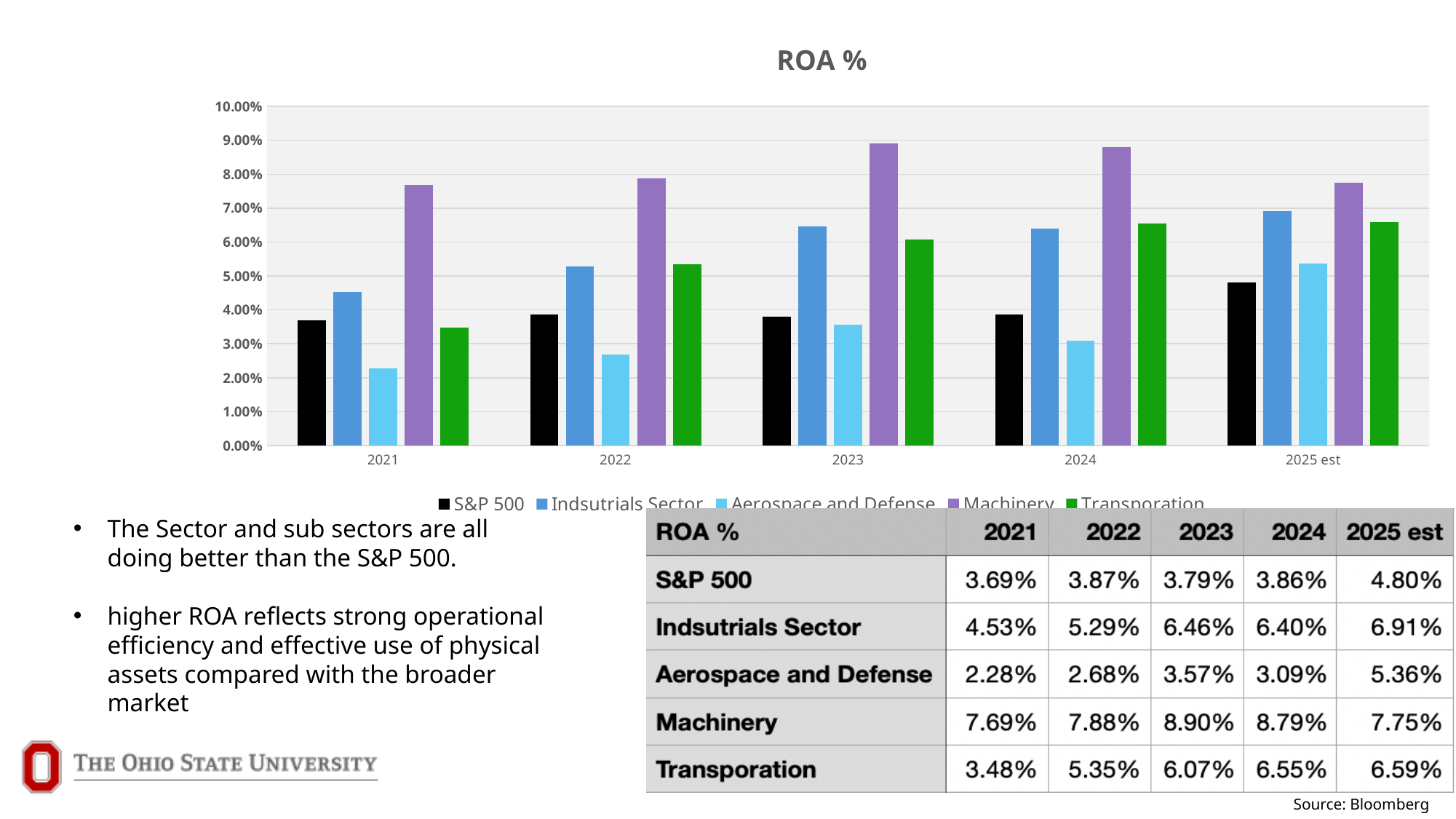
What kind of chart is shown on the slide? bar chart What is the difference between the Machinery and S&P 500 ROA % in 2022? 4.01% Which series has the highest ROA % in 2024? Machinery How many year categories are shown on the x axis of the chart? 5 What is the title of the chart? ROA % Does the ROA % for Aerospace and Defense rise or fall from 2024 to 2025 est? rise What is the ROA % for Machinery in 2023? 8.90% How many series does the chart's legend list? 5 Which is larger in 2023, the ROA % for the Industrials Sector or for Transportation? Industrials Sector What is the ROA % for the S&P 500 in 2025 est? 4.80% Which series has the lowest ROA % in 2021? Aerospace and Defense Is the ROA % for Machinery in 2021 greater or less than 7.00%? greater